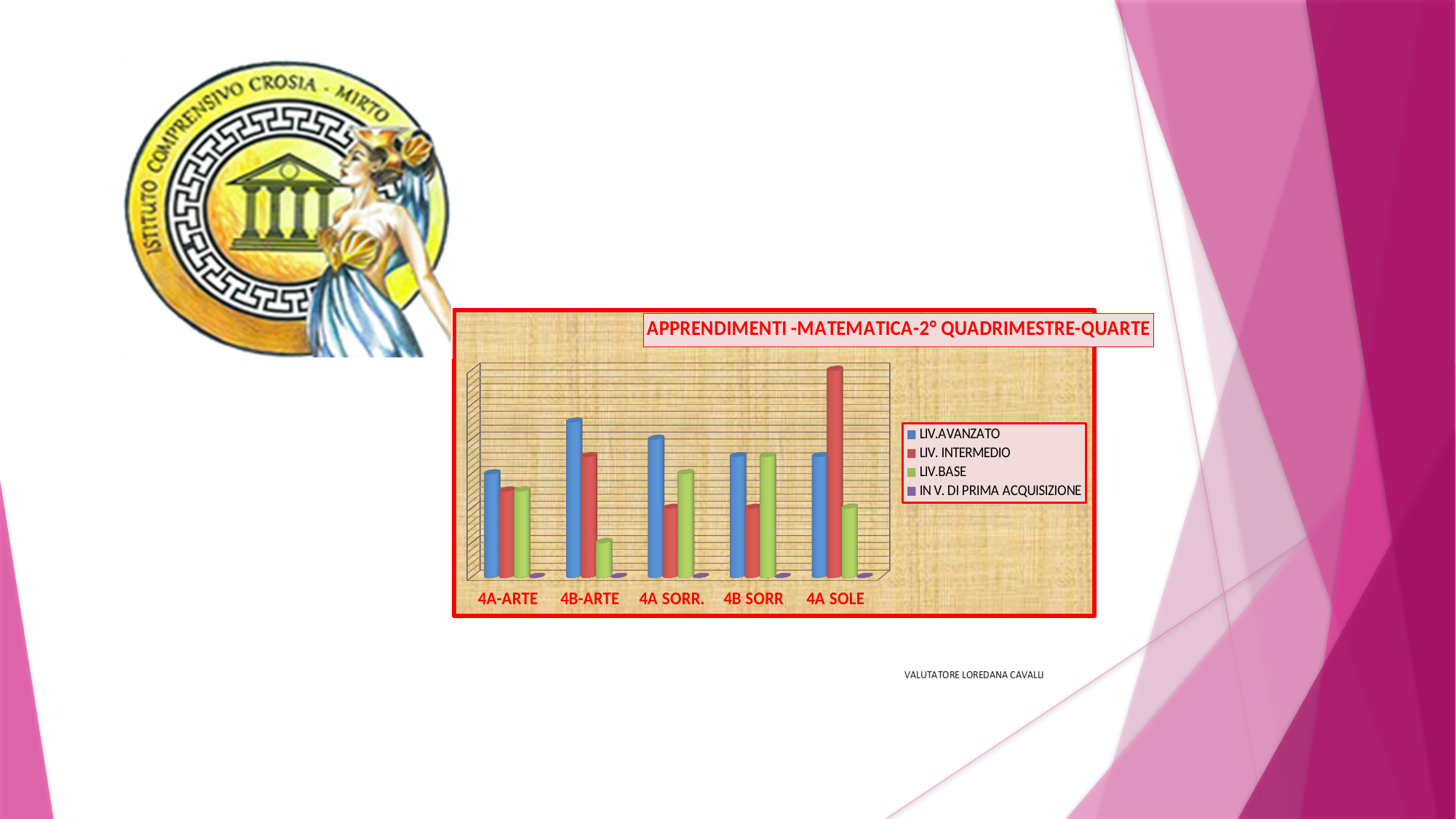
What is the title of the chart? APPRENDIMENTI -MATEMATICA-2° QUADRIMESTRE-QUARTE Which colour represents LIV.AVANZATO in the chart's legend? Blue What kind of chart is shown on the slide? Bar chart Which category has the highest LIV. INTERMEDIO bar? 4A SOLE How many categories (classes) are shown on the x axis of the chart? 5 In 4A SOLE, which is larger: LIV.AVANZATO or LIV. INTERMEDIO? LIV. INTERMEDIO Which category has the highest LIV.AVANZATO bar? 4B-ARTE Which category has the lowest LIV.BASE bar? 4B-ARTE In 4B-ARTE, which is larger: LIV. INTERMEDIO or LIV.BASE? LIV. INTERMEDIO In 4A SORR., which is larger: LIV.AVANZATO or LIV. INTERMEDIO? LIV.AVANZATO Which series has the lowest values across all categories? IN V. DI PRIMA ACQUISIZIONE How many series does the chart's legend list? 4